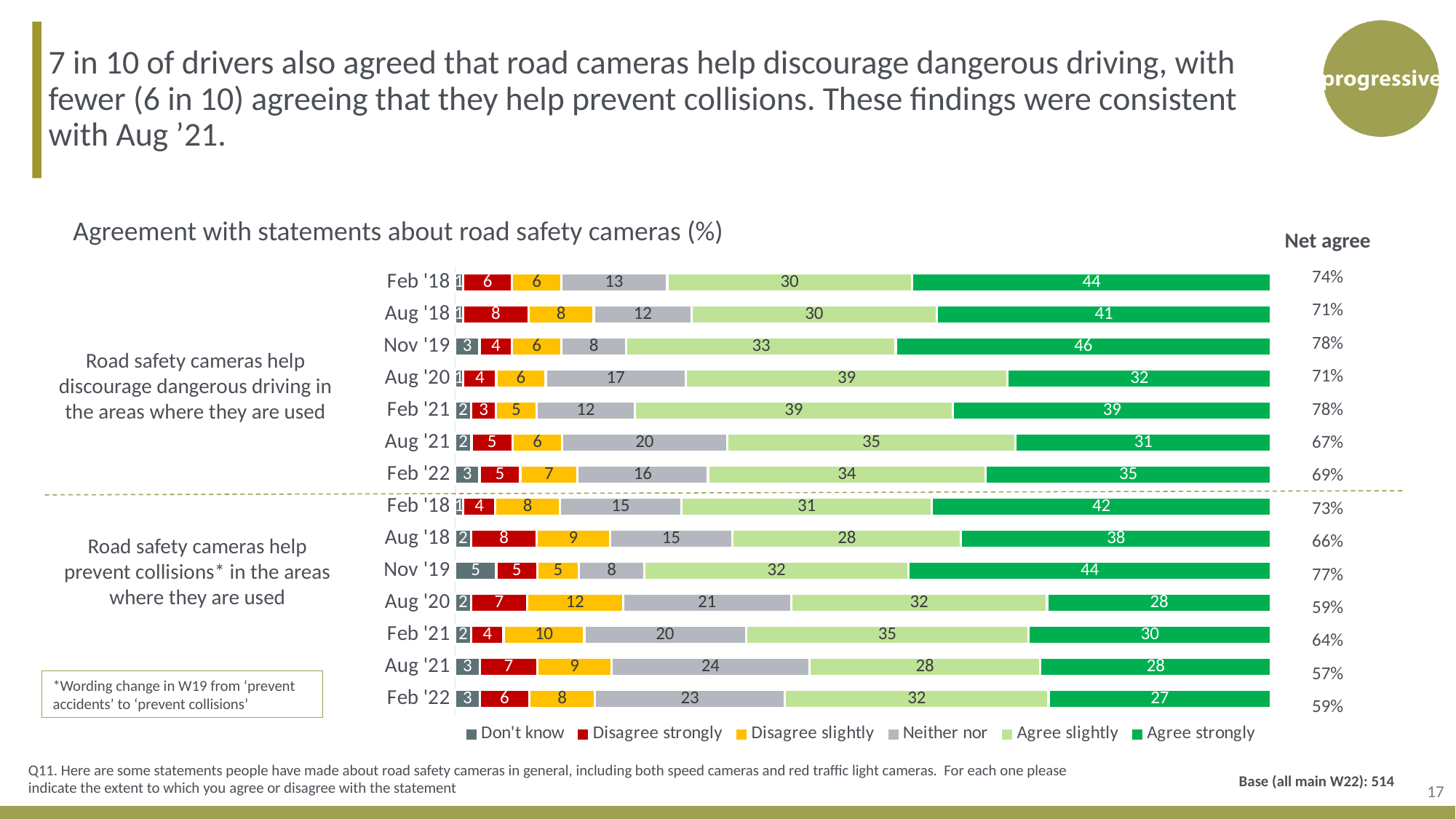
What is the title of the chart? Agreement with statements about road safety cameras (%) How many waves (time points) are shown for each statement? 7 For the 'discourage dangerous driving' statement, what is the difference between the 'Agree slightly' values for Aug '20 and Feb '18? 9 For the statement 'Road safety cameras help discourage dangerous driving in the areas where they are used', what is the 'Agree strongly' value for Nov '19? 46 For the 'discourage dangerous driving' statement, which wave has the highest 'Agree strongly' value? Nov '19 For the statement 'Road safety cameras help prevent collisions in the areas where they are used', what is the 'Neither nor' value for Aug '21? 24 For the 'prevent collisions' statement, is the 'Agree strongly' value larger for Feb '18 or Feb '22? Feb '18 For the 'prevent collisions' statement, what is the combined 'Agree slightly' and 'Agree strongly' value for Nov '19? 76 How many series does the legend list? 6 What is the Net agree figure for Feb '22 for the statement about cameras helping prevent collisions? 59% What kind of chart is shown on the slide? Stacked bar chart For the 'prevent collisions' statement, which wave has the lowest Net agree figure? Aug '21